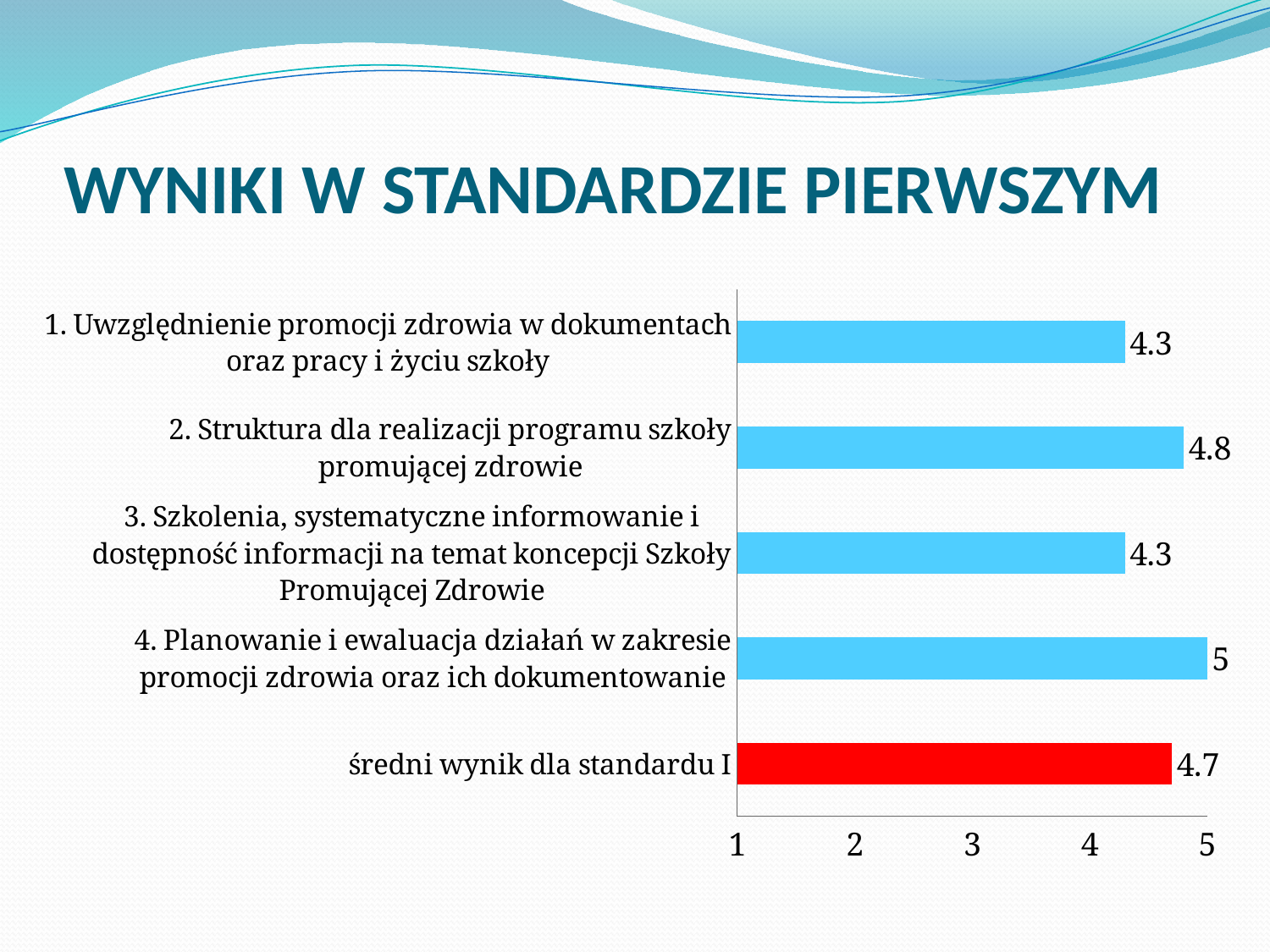
Which is larger: the value for category 3 or the value for "średni wynik dla standardu I"? średni wynik dla standardu I What kind of chart is shown on the slide? bar chart What is the title of the slide containing the chart? WYNIKI W STANDARDZIE PIERWSZYM What is the value for "2. Struktura dla realizacji programu szkoły promującej zdrowie"? 4.8 What is the value for "4. Planowanie i ewaluacja działań w zakresie promocji zdrowia oraz ich dokumentowanie"? 5 What is the value for "1. Uwzględnienie promocji zdrowia w dokumentach oraz pracy i życiu szkoły"? 4.3 What is the difference between the value for category 4 and the average ("średni wynik dla standardu I")? 0.3 What is the value for "średni wynik dla standardu I"? 4.7 What is the difference between the value for category 2 and the value for category 1? 0.5 Which category has the highest value? 4. Planowanie i ewaluacja działań w zakresie promocji zdrowia oraz ich dokumentowanie Which bar is coloured red? średni wynik dla standardu I How many bars are shown in the chart? 5